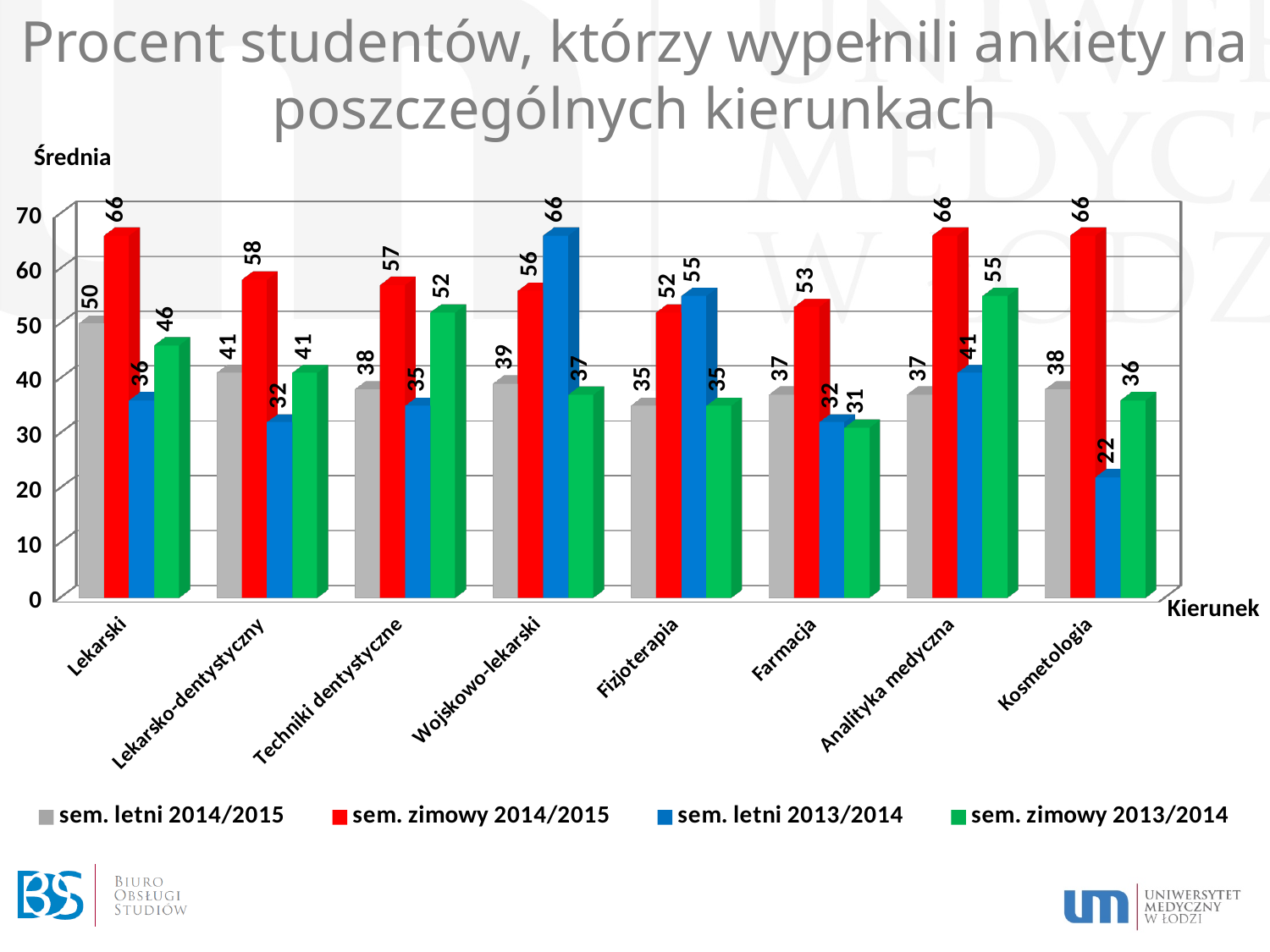
What is the value for Kosmetologia in the sem. letni 2013/2014 series? 22 What is the difference between the sem. zimowy 2014/2015 and sem. letni 2014/2015 values for Lekarsko-dentystyczny? 17 For Fizjoterapia, which is larger: the sem. zimowy 2014/2015 value or the sem. letni 2013/2014 value? sem. letni 2013/2014 Which category has the highest value in the sem. letni 2013/2014 series? Wojskowo-lekarski What is the value for Techniki dentystyczne in the sem. zimowy 2013/2014 series? 52 What kind of chart is shown on the slide? bar chart What is the label on the x axis of the chart? Kierunek How many categories (kierunki) are shown on the x axis? 8 How many series does the legend list? 4 What is the value for Lekarski in the sem. letni 2014/2015 series? 50 Which series is shown in red in the legend? sem. zimowy 2014/2015 Which category has the lowest value in the sem. zimowy 2013/2014 series? Farmacja